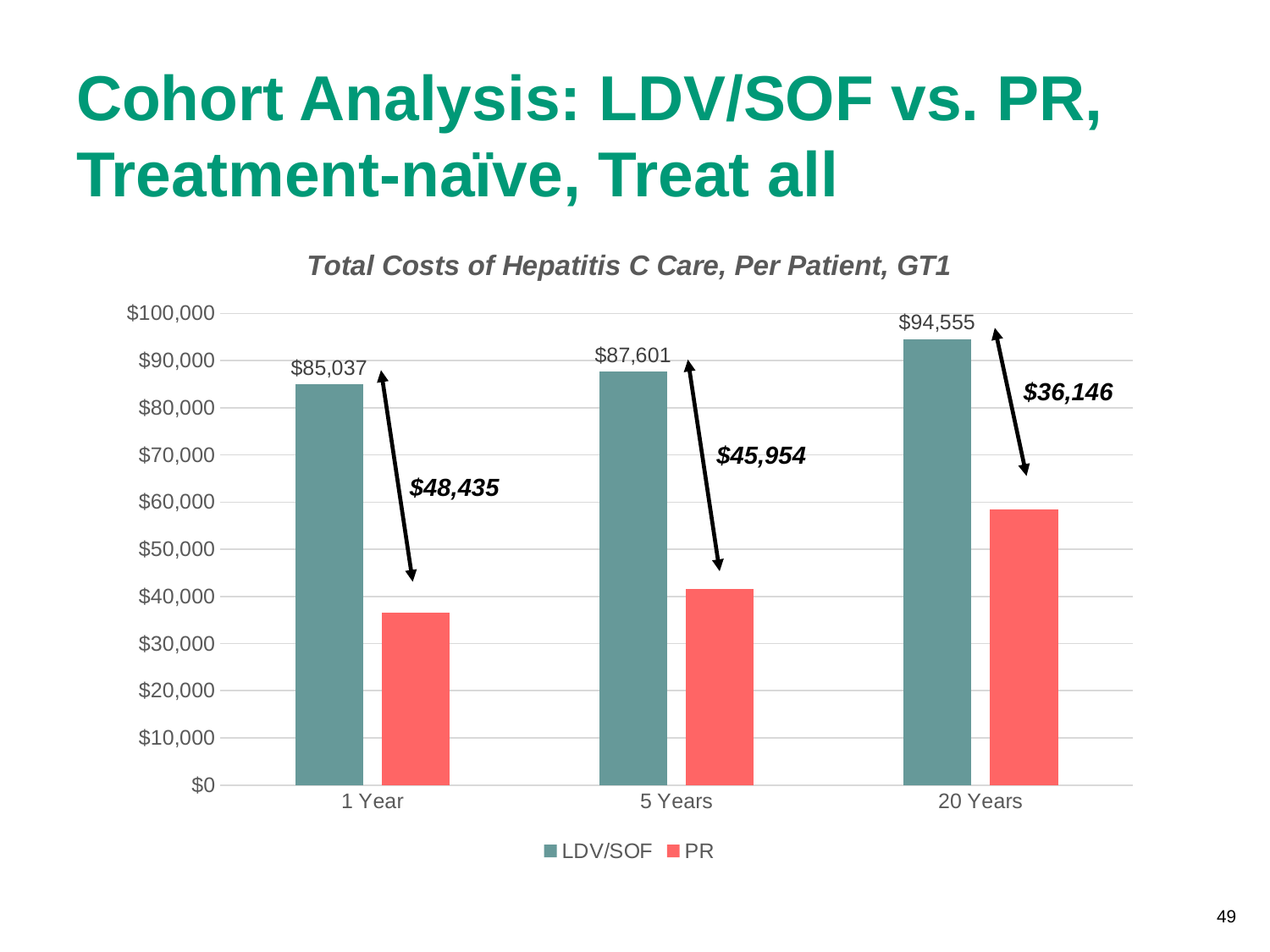
What is the LDV/SOF total cost per patient at 1 Year? $85,037 What is the difference between the LDV/SOF and PR costs at 1 Year, as annotated on the chart? $48,435 How many series does the legend list? 2 What is the difference between the LDV/SOF and PR costs at 20 Years, as annotated on the chart? $36,146 At 5 Years, which series has the higher cost, LDV/SOF or PR? LDV/SOF At which time horizon is the LDV/SOF cost lowest? 1 Year What is the LDV/SOF total cost per patient at 5 Years? $87,601 At which time horizon is the LDV/SOF cost highest? 20 Years Is the PR cost at 20 Years greater or less than $50,000? greater Is the PR cost at 1 Year greater or less than $40,000? less What is the LDV/SOF total cost per patient at 20 Years? $94,555 Do the LDV/SOF costs rise or fall from 1 Year to 20 Years? rise